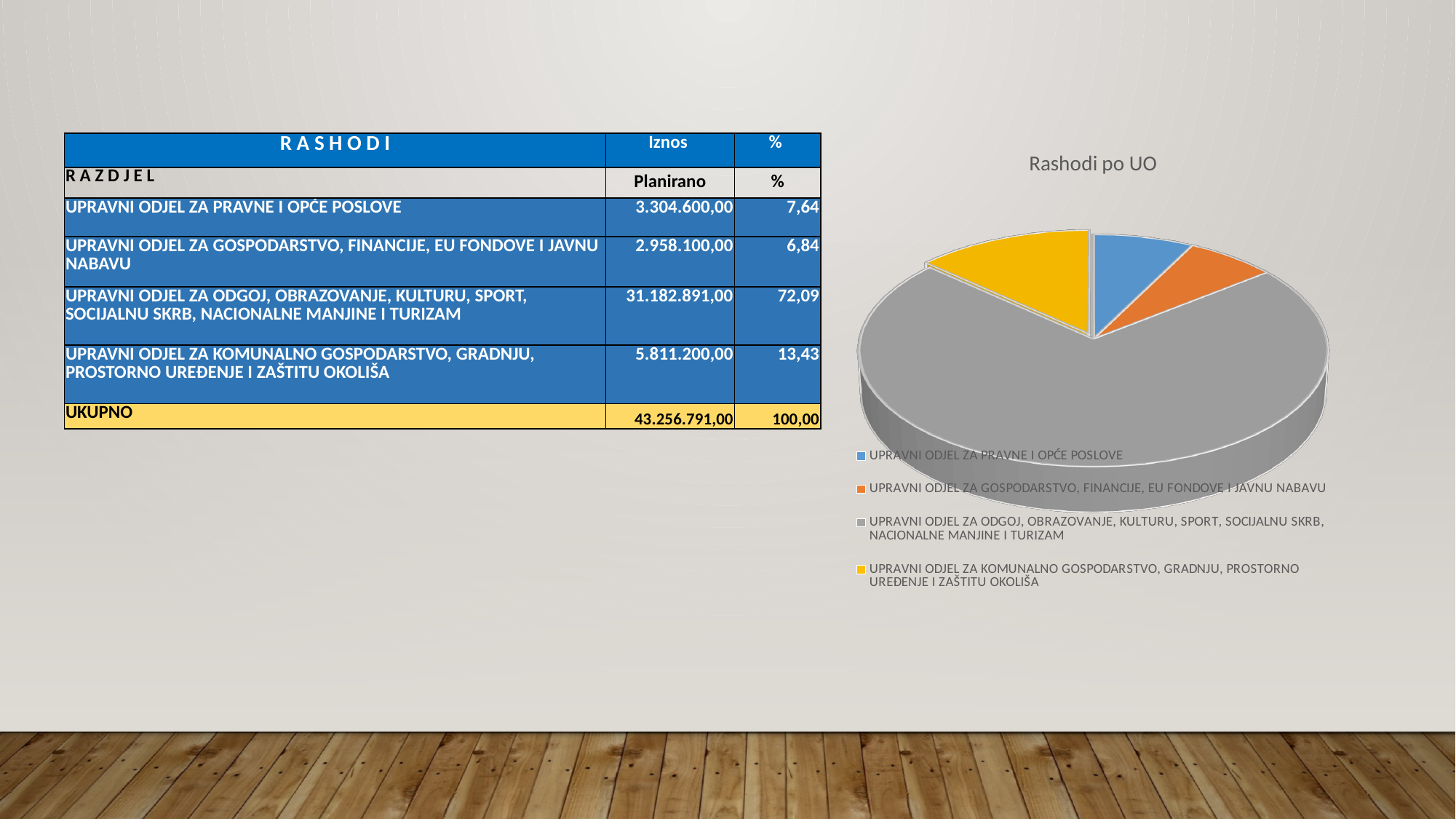
According to the table on the slide, what percentage share does UPRAVNI ODJEL ZA KOMUNALNO GOSPODARSTVO, GRADNJU, PROSTORNO UREĐENJE I ZAŠTITU OKOLIŠA have? 13,43 Which category has the largest slice in the pie chart? UPRAVNI ODJEL ZA ODGOJ, OBRAZOVANJE, KULTURU, SPORT, SOCIJALNU SKRB, NACIONALNE MANJINE I TURIZAM According to the table on the slide, what is the difference in planned amount between UPRAVNI ODJEL ZA PRAVNE I OPĆE POSLOVE and UPRAVNI ODJEL ZA GOSPODARSTVO, FINANCIJE, EU FONDOVE I JAVNU NABAVU? 346.500,00 How many entries does the legend of the pie chart list? 4 According to the table on the slide, what is the total (UKUPNO) planned amount? 43.256.791,00 According to the table on the slide, what is the planned amount (Planirano) for UPRAVNI ODJEL ZA PRAVNE I OPĆE POSLOVE? 3.304.600,00 What is the title of the pie chart? Rashodi po UO What kind of chart is shown on the slide? Pie chart Which slice is larger in the pie chart: UPRAVNI ODJEL ZA KOMUNALNO GOSPODARSTVO, GRADNJU, PROSTORNO UREĐENJE I ZAŠTITU OKOLIŠA or UPRAVNI ODJEL ZA PRAVNE I OPĆE POSLOVE? UPRAVNI ODJEL ZA KOMUNALNO GOSPODARSTVO, GRADNJU, PROSTORNO UREĐENJE I ZAŠTITU OKOLIŠA How many slices does the pie chart have? 4 Which colour represents UPRAVNI ODJEL ZA KOMUNALNO GOSPODARSTVO, GRADNJU, PROSTORNO UREĐENJE I ZAŠTITU OKOLIŠA in the pie chart? Yellow According to the table on the slide, what percentage share does UPRAVNI ODJEL ZA ODGOJ, OBRAZOVANJE, KULTURU, SPORT, SOCIJALNU SKRB, NACIONALNE MANJINE I TURIZAM have of the total expenditure? 72,09